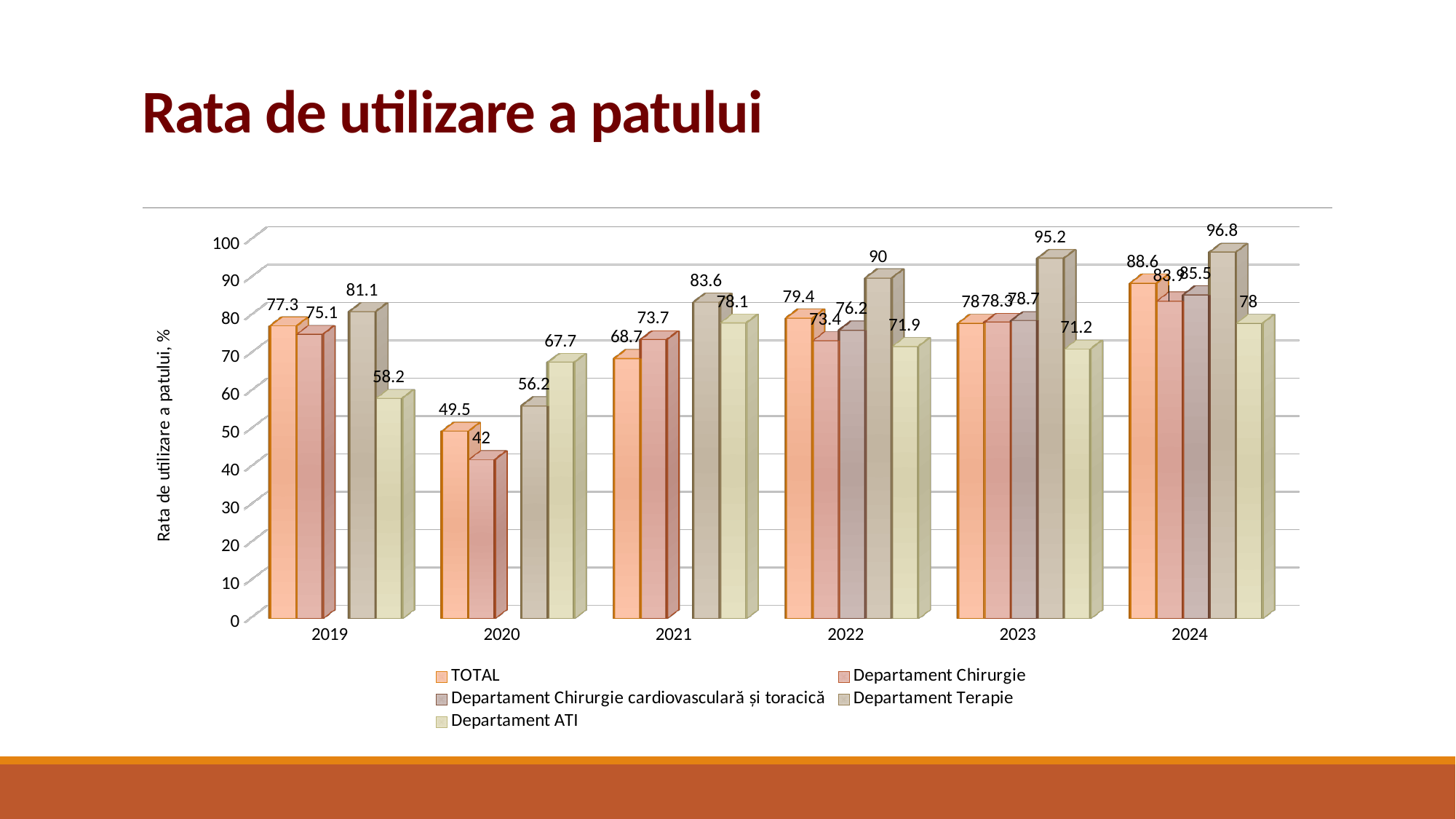
In which year is the value for Departament Chirurgie lowest? 2020 How many series does the legend list? 5 What is the title of the vertical axis? Rata de utilizare a patului, % In which year does Departament Terapie reach its highest value? 2024 What is the TOTAL value in 2020? 49.5 What kind of chart is shown on the slide? bar chart In 2021, which is larger: Departament Terapie or Departament ATI? Departament Terapie What is the difference between Departament Terapie and Departament ATI in 2022? 18.1 How many years are shown on the x axis? 6 What is the value for Departament ATI in 2019? 58.2 What is the value for Departament Terapie in 2023? 95.2 Does the value for Departament Terapie rise or fall from 2020 to 2024? rise